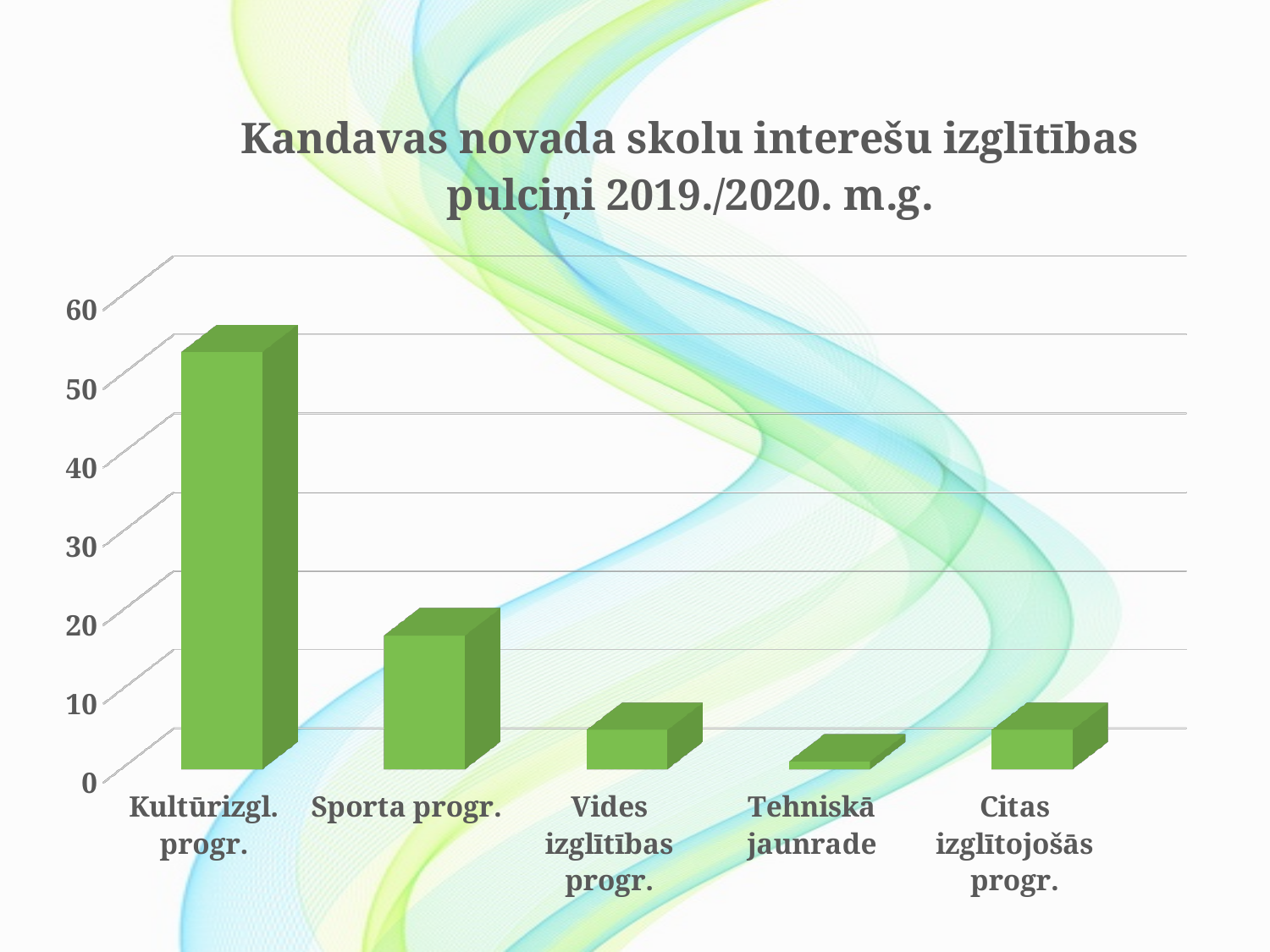
Is the value for Sporta progr. greater or less than 20? less Is the value for Kultūrizgl. progr. greater or less than 60? less Which category has the lowest bar? Tehniskā jaunrade Which is larger, the value for Vides izglītības progr. or the value for Tehniskā jaunrade? Vides izglītības progr. Is the value for Vides izglītības progr. greater or less than 10? less Which category has the highest bar? Kultūrizgl. progr. What is the title of the chart? Kandavas novada skolu interešu izglītības pulciņi 2019./2020. m.g. Which is larger, the value for Sporta progr. or the value for Citas izglītojošās progr.? Sporta progr. How many categories are shown on the x axis of the chart? 5 What kind of chart is shown on the slide? bar chart